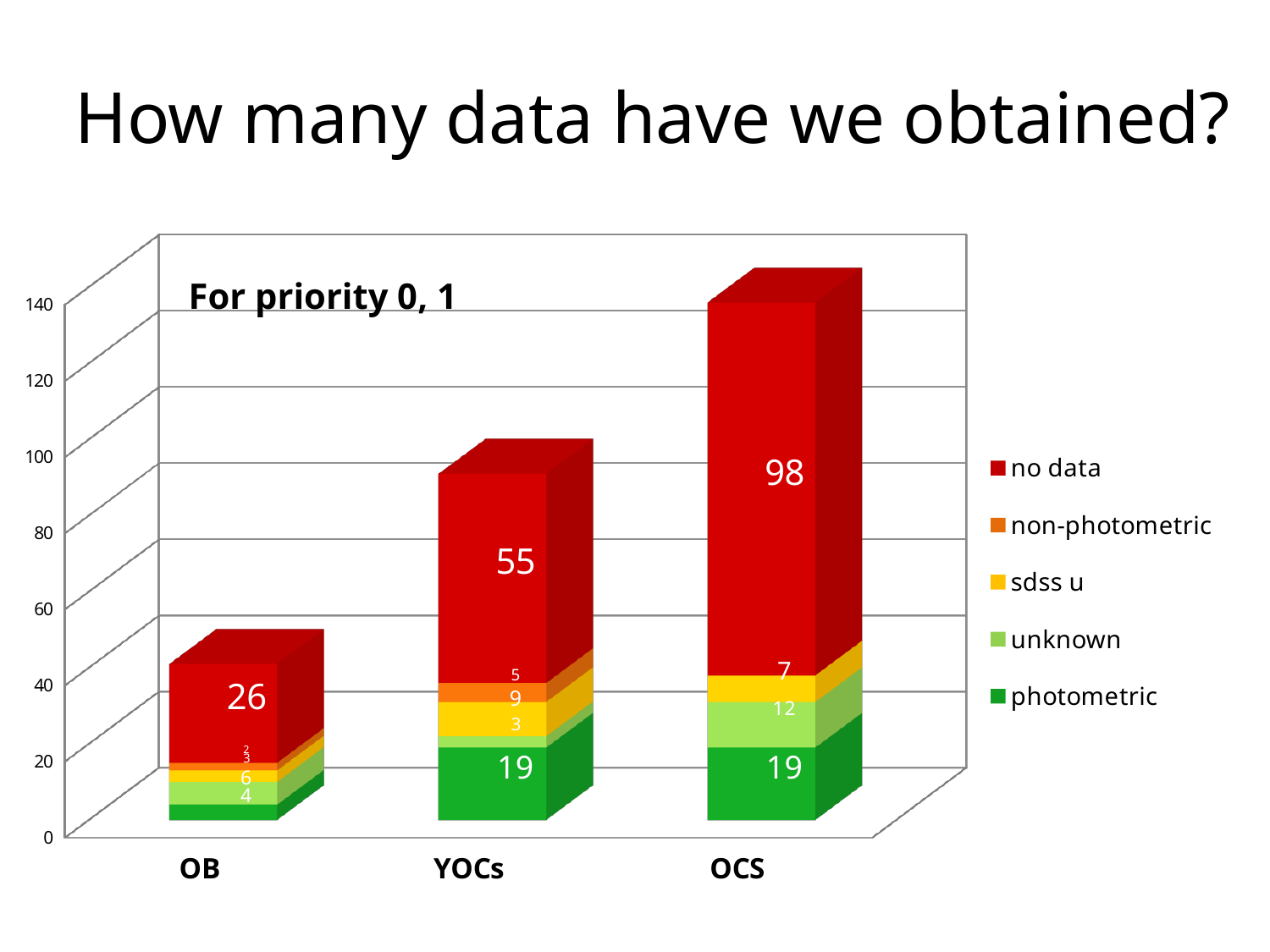
What is the total of the stacked bar for YOCs? 91 How many categories are shown on the x axis? 3 Which category has the largest "no data" segment? OCS What is the value of the "no data" segment for OCS? 98 How many series does the legend list? 5 Which has the larger "sdss u" value, YOCs or OCS? YOCs How much larger is the "no data" value for OCS than for YOCs? 43 What is the value of the "no data" segment for YOCs? 55 What is the "photometric" value for OB? 4 What is the "unknown" value for OCS? 12 What is the "sdss u" value for YOCs? 9 Which category has the smallest "photometric" segment? OB